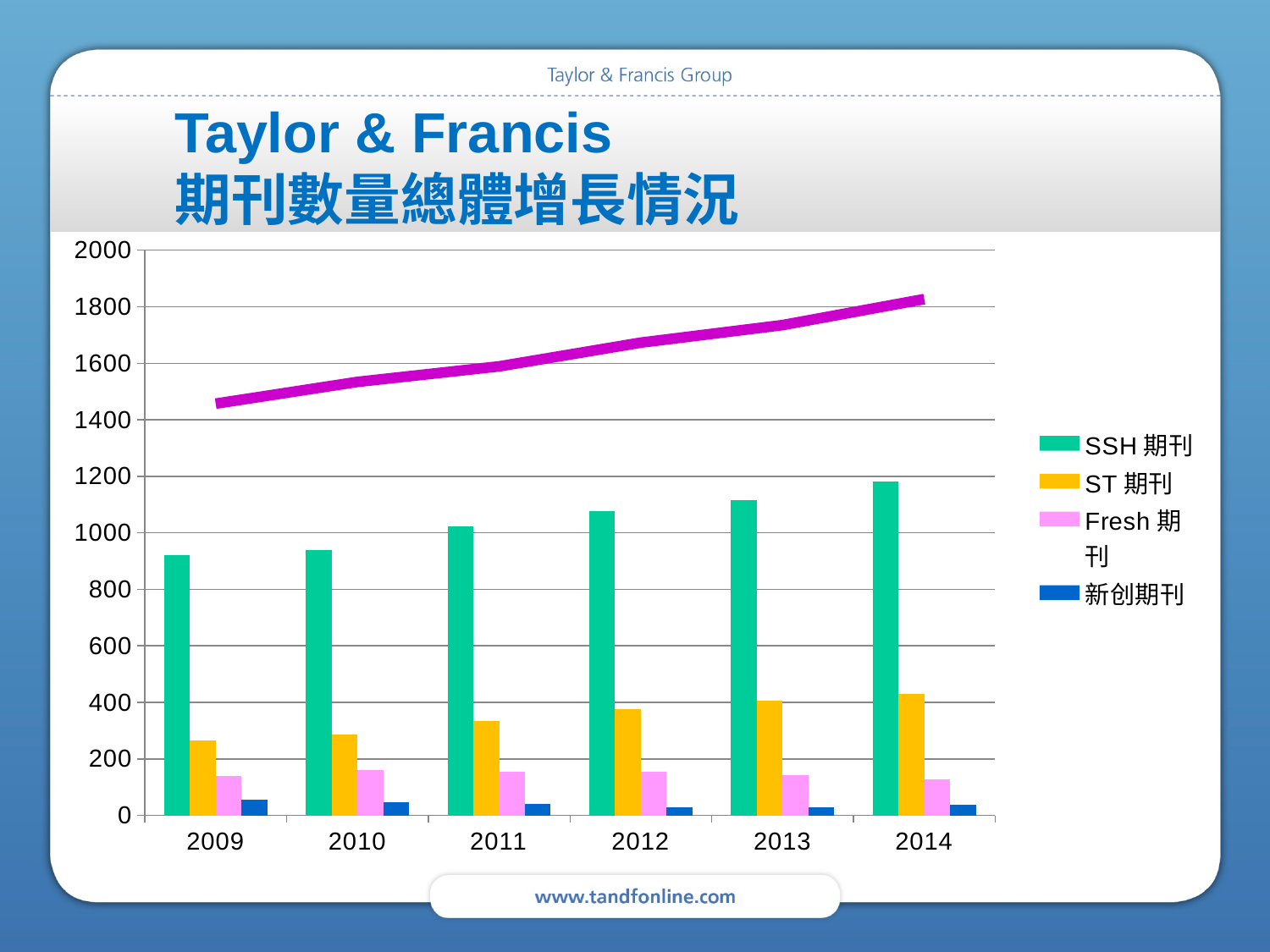
How many years are shown on the x axis? 6 What colour are the bars for SSH 期刊? green Do the values for SSH 期刊 rise or fall from 2009 to 2014? rise Which is larger in 2012, ST 期刊 or Fresh 期刊? ST 期刊 Is the value for SSH 期刊 in 2009 greater or less than 800? greater How many series does the legend list? 4 Is the value for ST 期刊 in 2014 greater or less than 400? greater Is the value for Fresh 期刊 in 2014 greater or less than 200? less Which year has the highest value for 新創期刊? 2009 Which year has the lowest value for SSH 期刊? 2009 Which year has the highest value for SSH 期刊? 2014 What kind of chart is shown on the slide? combination bar and line chart